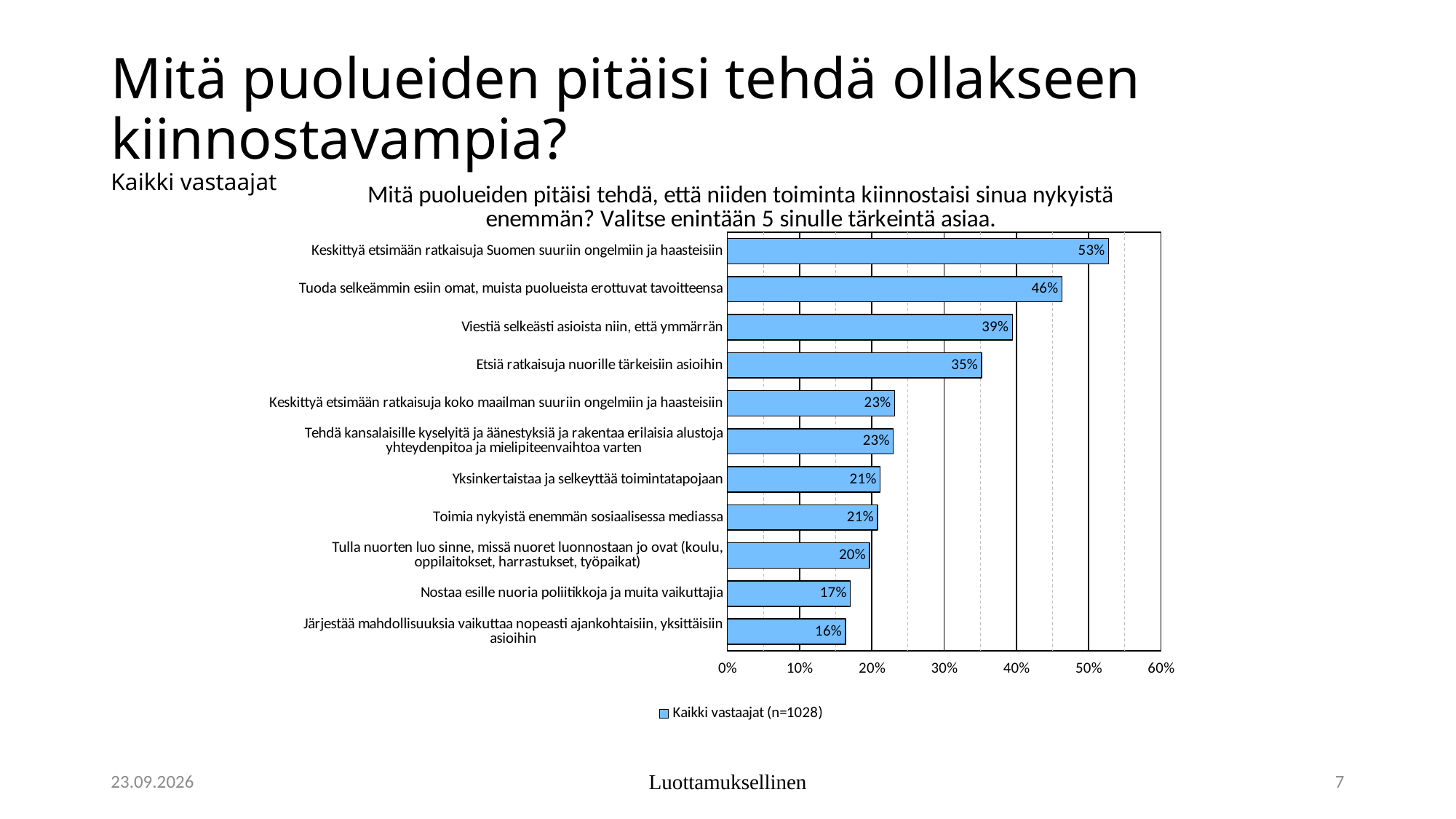
What is the value for "Nostaa esille nuoria poliitikkoja ja muita vaikuttajia"? 17% Which category has the highest value? Keskittyä etsimään ratkaisuja Suomen suuriin ongelmiin ja haasteisiin What is the value for "Viestiä selkeästi asioista niin, että ymmärrän"? 39% How many series does the legend list? 1 What kind of chart is shown on the slide? Bar chart How many categories are shown in the chart? 11 What is the legend entry of the chart? Kaikki vastaajat (n=1028) What is the value for "Keskittyä etsimään ratkaisuja Suomen suuriin ongelmiin ja haasteisiin"? 53% What is the difference between the values for "Tuoda selkeämmin esiin omat, muista puolueista erottuvat tavoitteensa" and "Etsiä ratkaisuja nuorille tärkeisiin asioihin"? 11% Which is larger: the value for "Toimia nykyistä enemmän sosiaalisessa mediassa" or the value for "Nostaa esille nuoria poliitikkoja ja muita vaikuttajia"? Toimia nykyistä enemmän sosiaalisessa mediassa Which category has the lowest value? Järjestää mahdollisuuksia vaikuttaa nopeasti ajankohtaisiin, yksittäisiin asioihin Is the value for "Etsiä ratkaisuja nuorille tärkeisiin asioihin" greater or less than 30%? greater